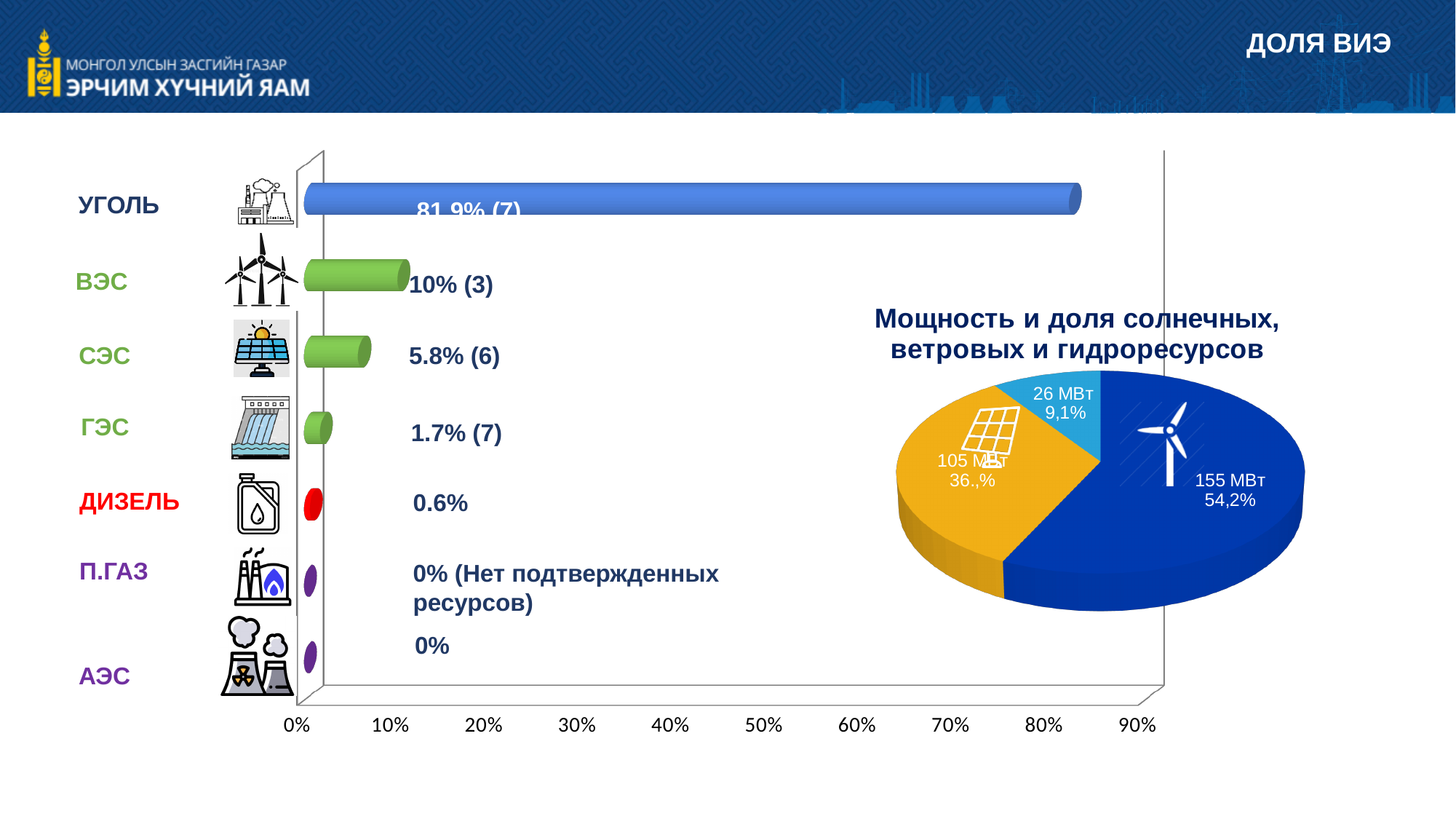
In the bar chart on the left, how many categories are shown? 7 In the pie chart titled 'Мощность и доля солнечных, ветровых и гидроресурсов', what share does the 155 МВт slice have? 54,2% In the bar chart on the left, what is the value shown for СЭС? 5.8% (6) In the bar chart on the left, which is larger, the value for ВЭС or the value for СЭС? ВЭС What kind of chart is the chart on the left of the slide? bar chart In the bar chart on the left, what is the value shown for ВЭС? 10% (3) In the bar chart on the left, what is the value shown for ДИЗЕЛЬ? 0.6% In the bar chart on the left, which category has the highest value? УГОЛЬ In the pie chart titled 'Мощность и доля солнечных, ветровых и гидроресурсов', what is the capacity shown for the smallest slice? 26 МВт In the bar chart on the left, what is the value shown for ГЭС? 1.7% (7) In the bar chart on the left, what is the difference between the percentage for ВЭС and the percentage for СЭС? 4.2% In the bar chart on the left, what is the value shown for УГОЛЬ? 81.9% (7)